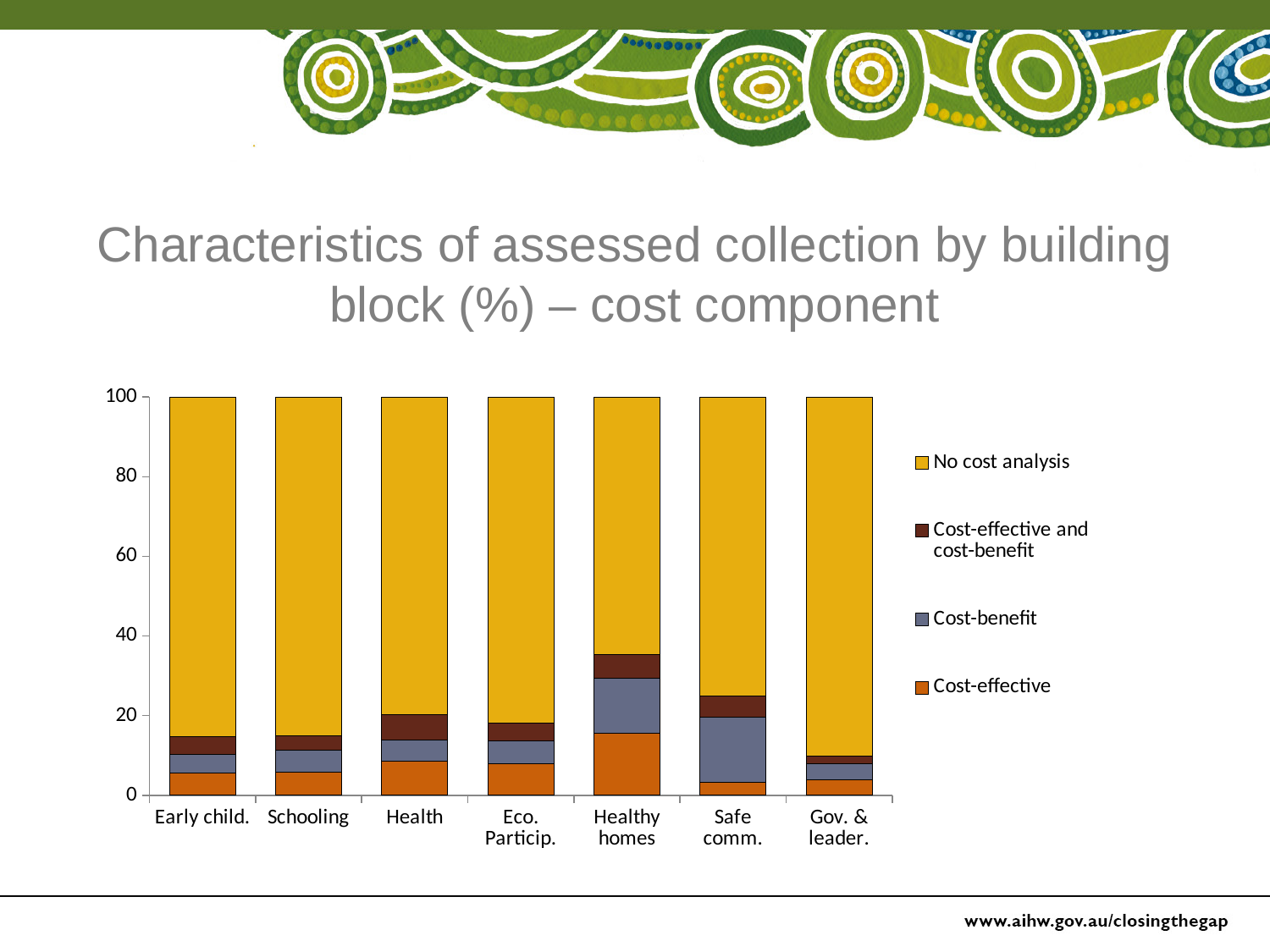
Is the Cost-effective value for Healthy homes greater or less than 10? greater What kind of chart is shown on the slide? Stacked bar chart Which building block has the largest No cost analysis segment? Gov. & leader. How many building blocks (categories) are shown on the x axis? 7 Which colour represents No cost analysis in the legend? Yellow What is the total height of the stacked bar for Schooling? 100 Is the Cost-benefit value for Safe comm. greater or less than 10? greater Which building block has the largest Cost-effective segment? Healthy homes Which is larger, the Cost-effective segment for Healthy homes or for Schooling? Healthy homes Which building block has the smallest No cost analysis segment? Healthy homes How many series does the legend list? 4 Is the Cost-effective value for Early child. greater or less than 10? less